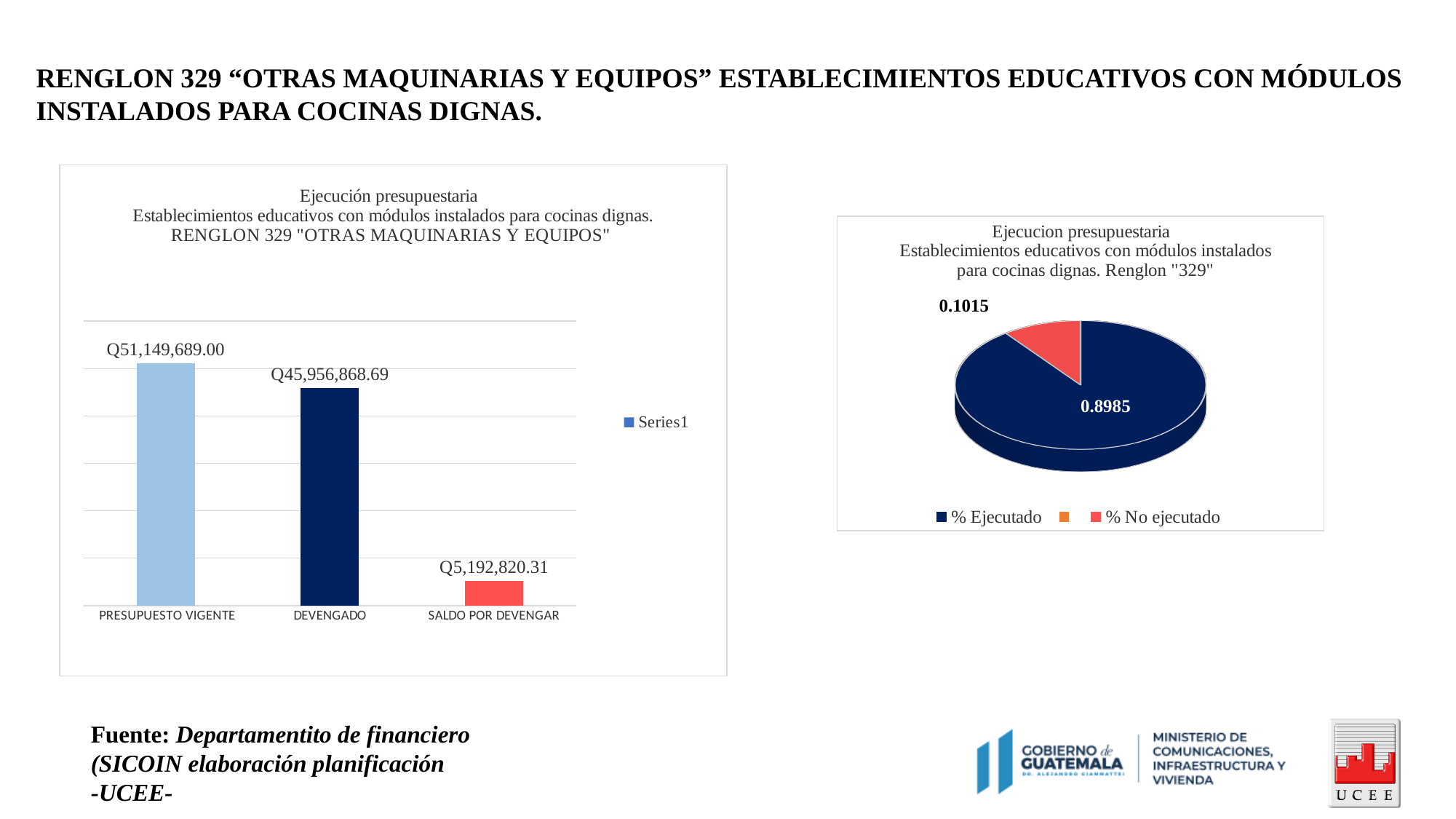
How many categories are shown in the bar chart on the left? 3 In the pie chart on the right, what is the value shown for % Ejecutado? 0.8985 In the bar chart on the left, what is the difference between PRESUPUESTO VIGENTE and DEVENGADO? Q5,192,820.31 In the bar chart on the left, what is the value for SALDO POR DEVENGAR? Q5,192,820.31 In the pie chart on the right, what is the value shown for % No ejecutado? 0.1015 In the bar chart on the left, which category has the lowest value? SALDO POR DEVENGAR In the bar chart on the left, what is the value for PRESUPUESTO VIGENTE? Q51,149,689.00 What kind of chart is the chart on the left of the slide? Bar chart In the bar chart on the left, what is the value for DEVENGADO? Q45,956,868.69 What kind of chart is the chart on the right of the slide? Pie chart In the bar chart on the left, which category has the highest value? PRESUPUESTO VIGENTE In the bar chart on the left, which is larger, DEVENGADO or SALDO POR DEVENGAR? DEVENGADO